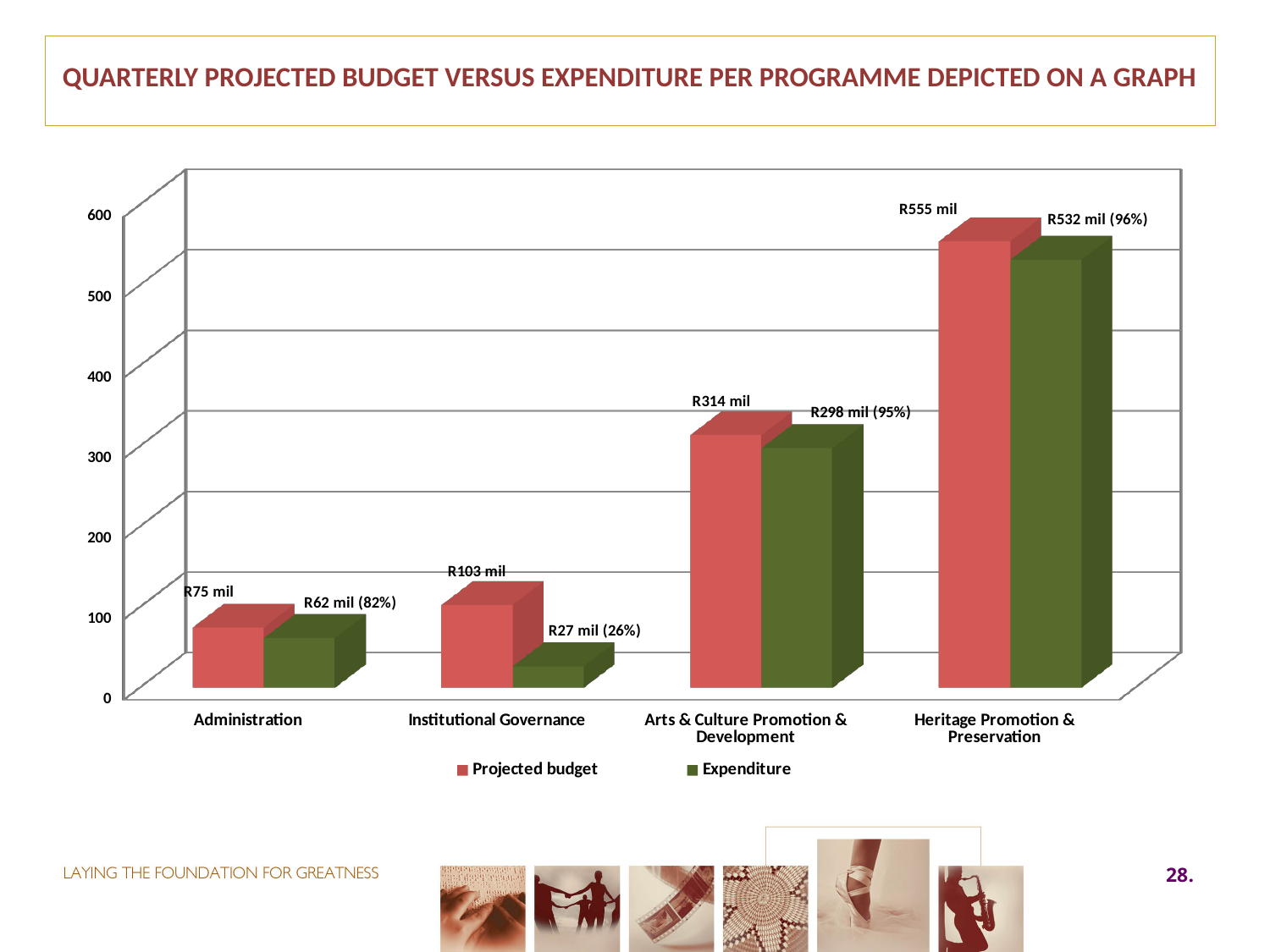
Is the expenditure for Arts & Culture Promotion & Development greater or less than 200? greater Which programme has the lowest expenditure? Institutional Governance Which is larger for Administration, the projected budget or the expenditure? Projected budget What is the expenditure for Institutional Governance? R27 mil (26%) How many series does the legend list? 2 What is the expenditure for Heritage Promotion & Preservation? R532 mil (96%) What is the difference between the projected budget and the expenditure for Institutional Governance? R76 mil What kind of chart is shown on the slide? Bar chart How many programmes are shown on the x axis? 4 What is the projected budget for Arts & Culture Promotion & Development? R314 mil Which programme has the highest projected budget? Heritage Promotion & Preservation What is the projected budget for Administration? R75 mil